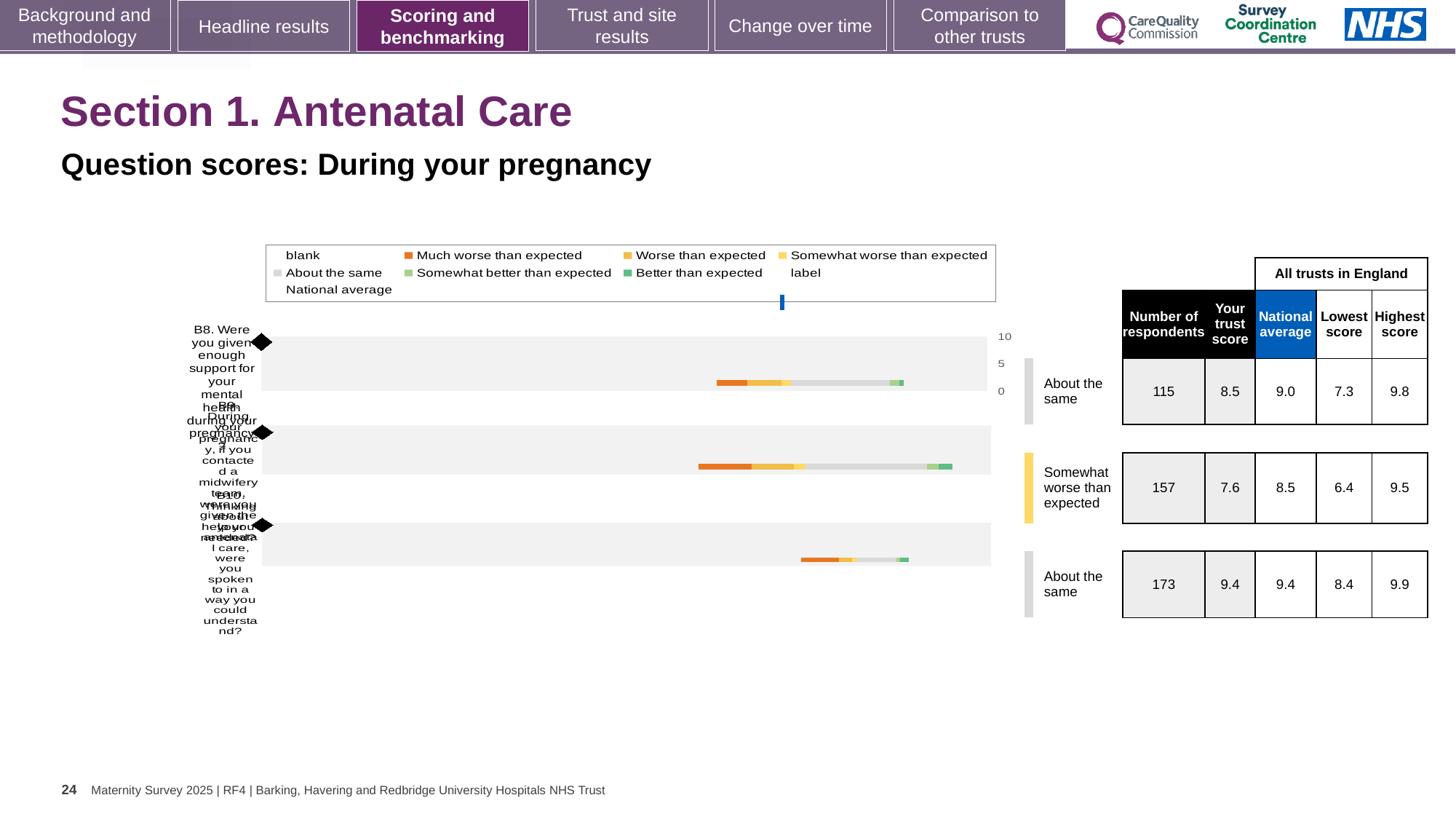
What is the highest tick value shown on the chart's score axis? 10 In the table next to the chart, what is the national average for the bottom row (B10)? 9.4 What benchmark label is shown for the middle row (B9)? Somewhat worse than expected In the table next to the chart, what is 'Your trust score' for the middle row (B9)? 7.6 For the top row (B8), which is larger: your trust score or the national average? National average In the table next to the chart, what is the number of respondents for the top row (B8)? 115 How many horizontal bars (questions) are plotted in the chart? 3 What kind of chart is shown on the slide? bar chart What colour does the legend use for 'Much worse than expected'? orange In the table next to the chart, what is the lowest score for the top row (B8)? 7.3 For the middle row (B9), what is the difference between the highest score and the lowest score? 3.1 Which row in the table has the highest number of respondents? Bottom row (B10), 173